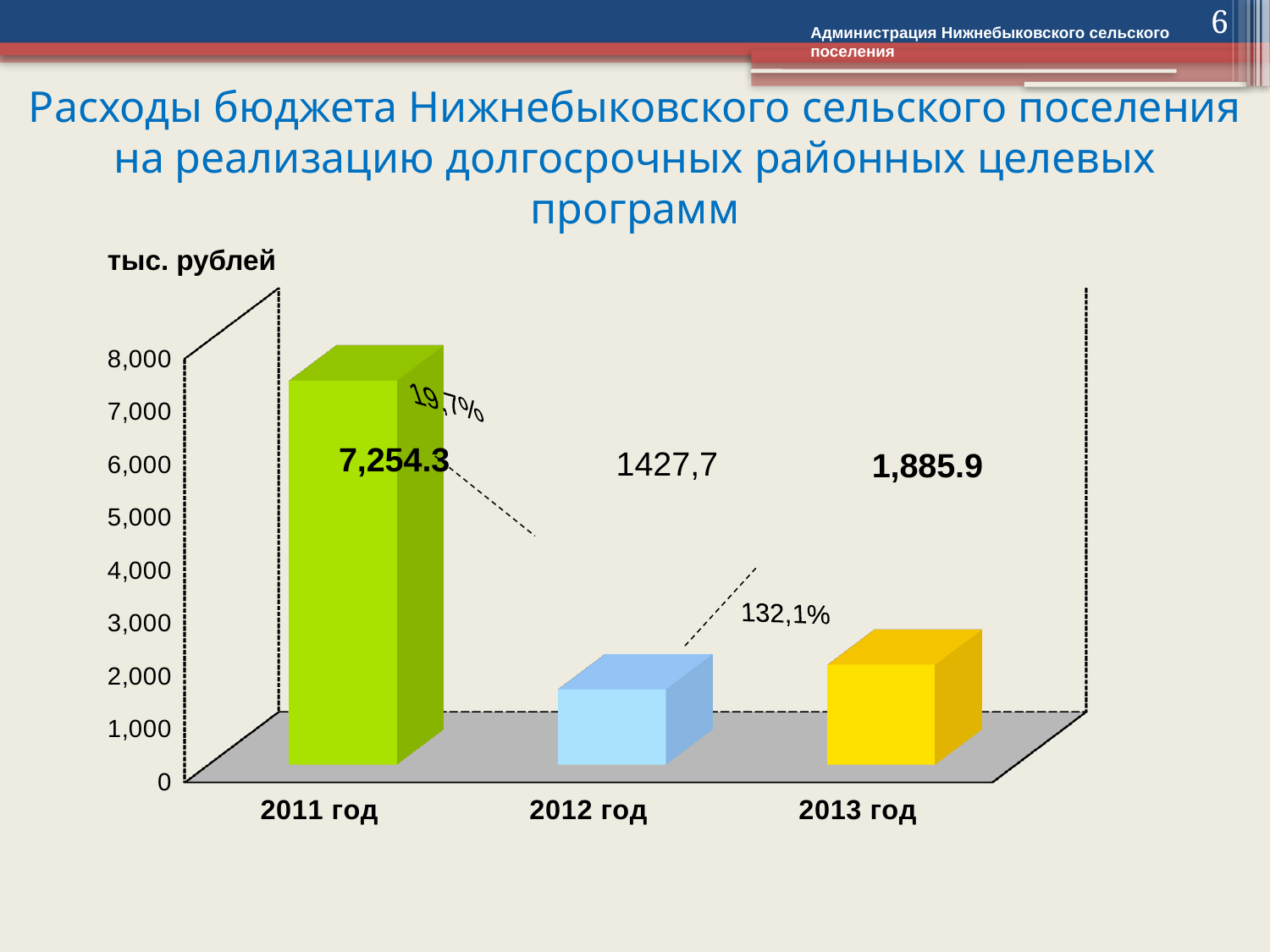
What unit is shown above the vertical axis? тыс. рублей What is the value for 2011 год? 7,254.3 What is the value for 2013 год? 1,885.9 Which is larger, the value for 2013 год or the value for 2012 год? 2013 год What is the value for 2012 год? 1427,7 How many years are shown on the x axis? 3 What type of chart is shown on the slide? bar chart Does the value fall or rise from 2011 год to 2012 год? fall Is the value for 2012 год greater or less than 2,000? less What is the difference between the values for 2011 год and 2013 год? 5,368.4 Which year has the lowest value? 2012 год Which year has the highest value? 2011 год